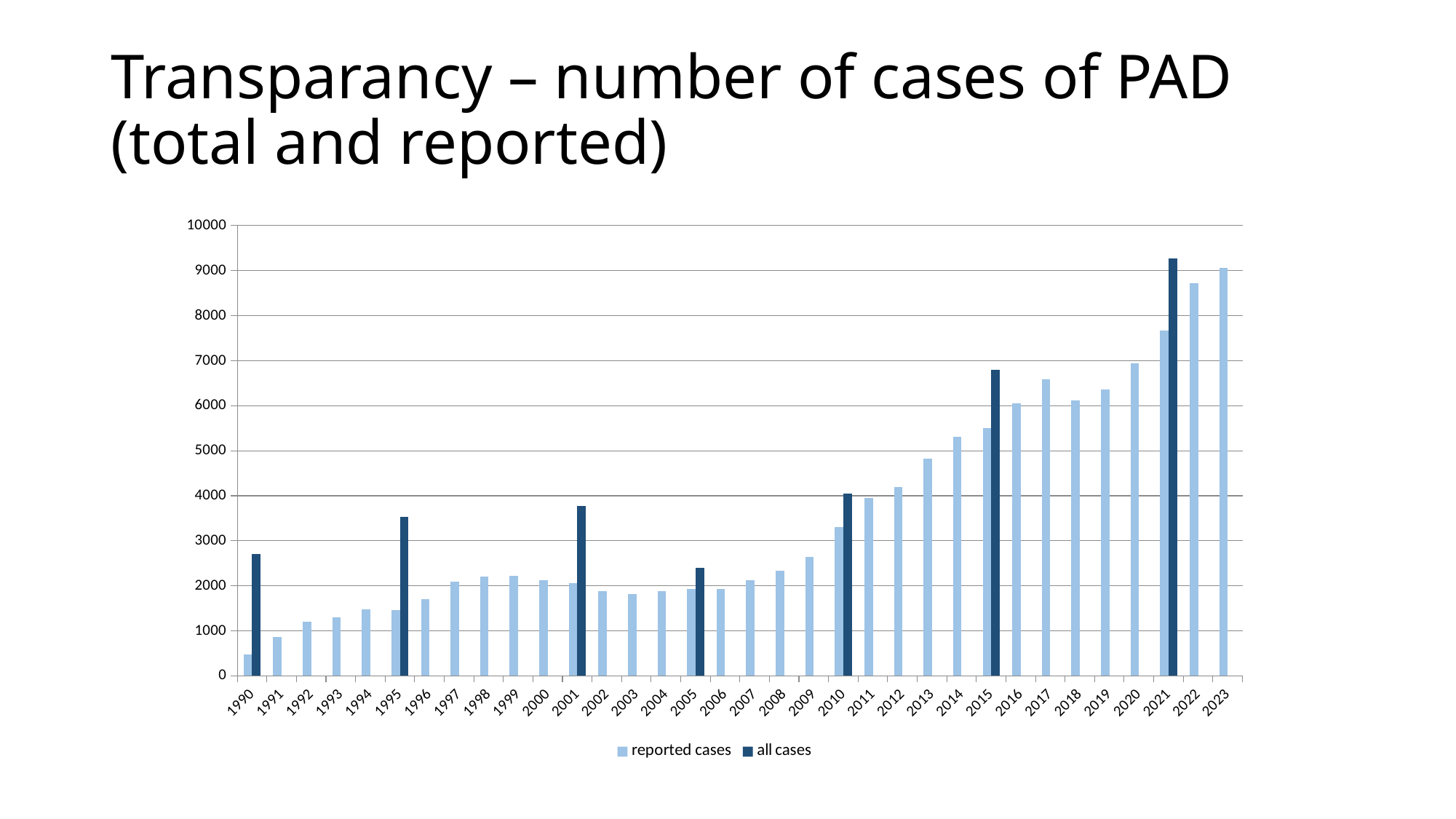
For how many years is an 'all cases' bar plotted? 7 Which series is shown in the darker blue colour? all cases Overall, do the reported cases rise or fall from 1990 to 2023? rise Which year has the highest value for reported cases? 2023 What kind of chart is shown on the slide? bar chart Which year has the highest value for all cases? 2021 Which year has the lowest value for reported cases? 1990 Is the value for all cases in 2015 greater or less than 7000? less Is the value for reported cases in 2022 greater or less than 8000? greater How many series does the legend list? 2 How many years are shown on the x axis? 34 Which is larger: reported cases in 2017 or reported cases in 2018? 2017